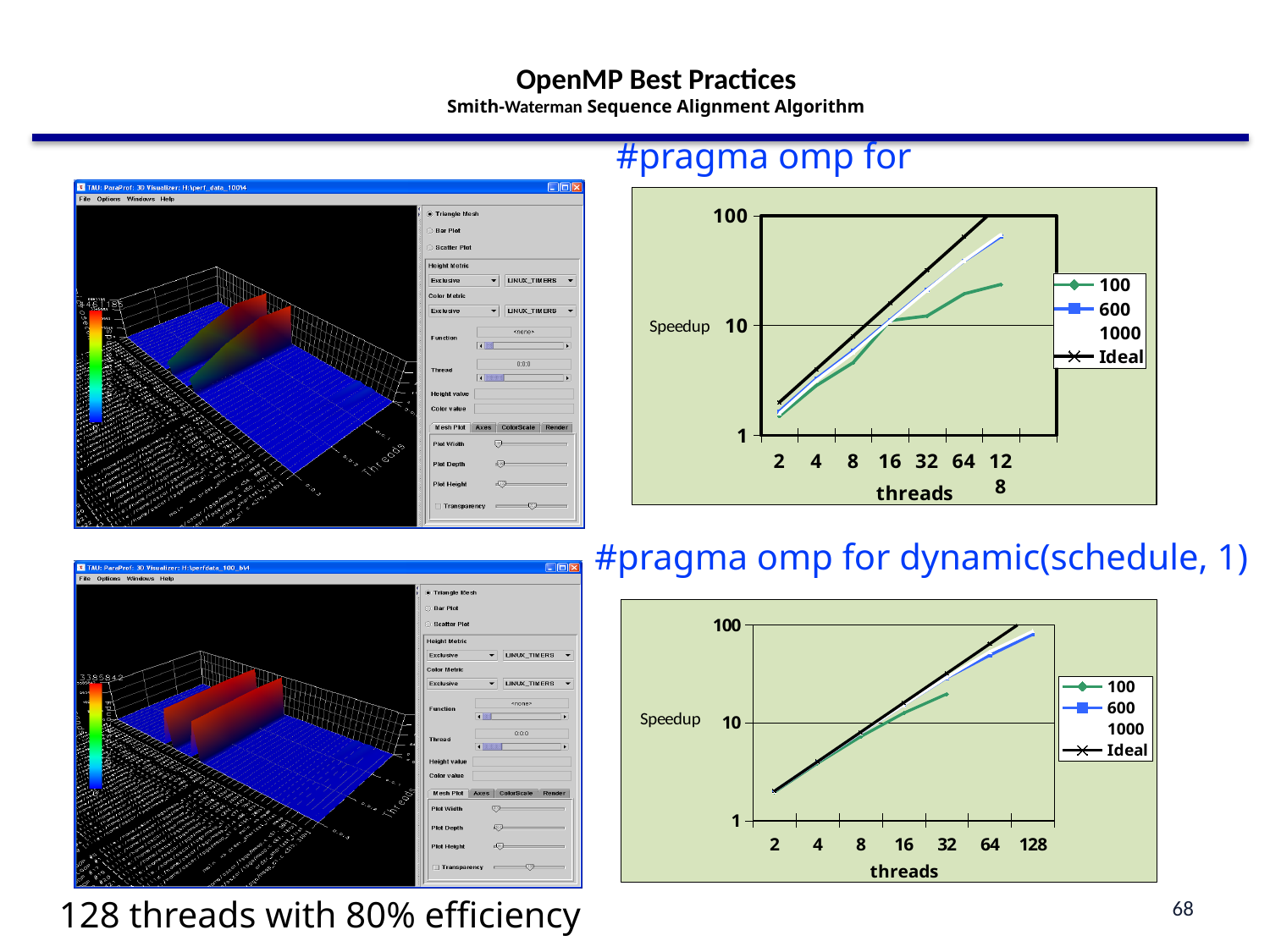
In the '#pragma omp for' chart, what are the legend entries? 100, 600, 1000, Ideal In the '#pragma omp for dynamic(schedule, 1)' chart, is the speedup of the 'Ideal' series at 64 threads greater or less than 10? greater In the '#pragma omp for' chart, does the speedup rise or fall as the number of threads increases? rise In the '#pragma omp for' chart, what is the label of the y axis? Speedup In the '#pragma omp for dynamic(schedule, 1)' chart, at 32 threads, which series has the higher speedup, 'Ideal' or '100'? Ideal What kind of chart is the '#pragma omp for' chart on the right of the slide? line chart In the '#pragma omp for dynamic(schedule, 1)' chart, is the speedup of the '600' series at 2 threads greater or less than 10? less In the '#pragma omp for' chart, is the speedup of the '600' series at 128 threads greater or less than 10? greater How many thread counts are marked on the x axis of the '#pragma omp for' chart? 7 In the '#pragma omp for' chart, at 128 threads, which series has the higher speedup, '100' or '600'? 600 How many series does the legend of the '#pragma omp for' chart list? 4